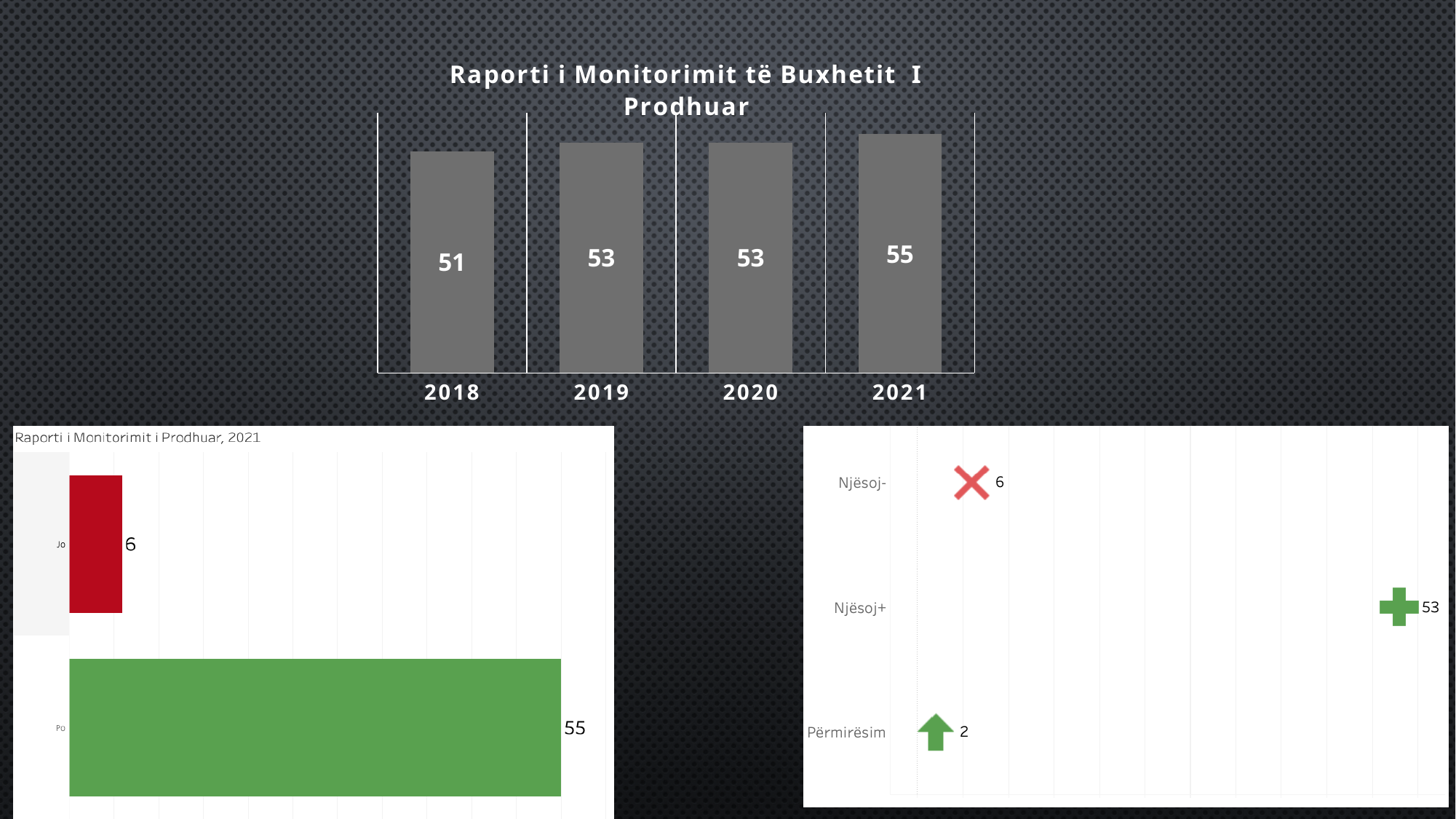
In the chart titled 'Raporti i Monitorimit të Buxhetit I Prodhuar', what is the value for 2018? 51 In the chart titled 'Raporti i Monitorimit të Buxhetit I Prodhuar', how many years are shown? 4 In the chart titled 'Raporti i Monitorimit i Prodhuar, 2021', what is the value for 'Po'? 55 In the chart at the bottom right of the slide, what is the value for 'Përmirësim'? 2 In the chart titled 'Raporti i Monitorimit të Buxhetit I Prodhuar', what is the value for 2021? 55 In the chart titled 'Raporti i Monitorimit të Buxhetit I Prodhuar', which year has the highest value? 2021 What kind of chart is the chart titled 'Raporti i Monitorimit i Prodhuar, 2021' at the bottom left? bar chart In the chart titled 'Raporti i Monitorimit të Buxhetit I Prodhuar', do the values generally rise or fall from 2018 to 2021? rise In the chart titled 'Raporti i Monitorimit të Buxhetit I Prodhuar', which year has the lowest value? 2018 In the chart at the bottom right of the slide, what is the value for 'Njësoj+'? 53 In the chart titled 'Raporti i Monitorimit i Prodhuar, 2021', which is larger, 'Jo' or 'Po'? Po In the chart titled 'Raporti i Monitorimit të Buxhetit I Prodhuar', what is the difference between the values for 2021 and 2018? 4